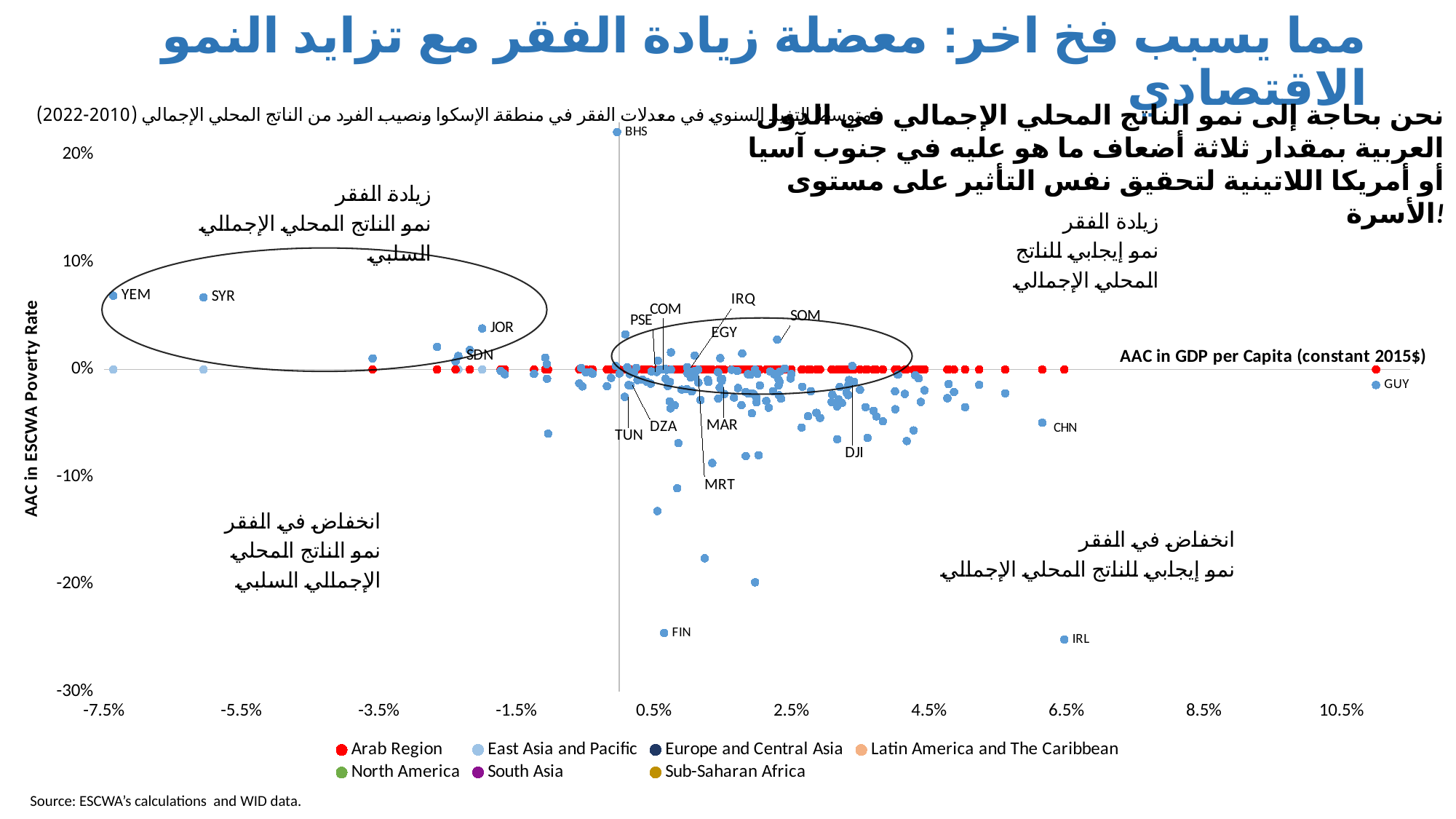
What kind of chart is shown on the slide? Scatter chart What is the label of the vertical axis of the chart? AAC in ESCWA Poverty Rate What is the label of the horizontal axis of the chart? AAC in GDP per Capita (constant 2015$) Is the GDP per capita value for CHN greater or less than 4.5%? greater Which has the higher poverty rate value, YEM or FIN? YEM Which has the higher GDP per capita value, YEM or GUY? GUY Is the GDP per capita value for YEM greater or less than -5.5%? less Is the GDP per capita value for GUY greater or less than 8.5%? greater Which labeled point has the highest poverty rate value on the chart? BHS How many series does the chart legend list? 7